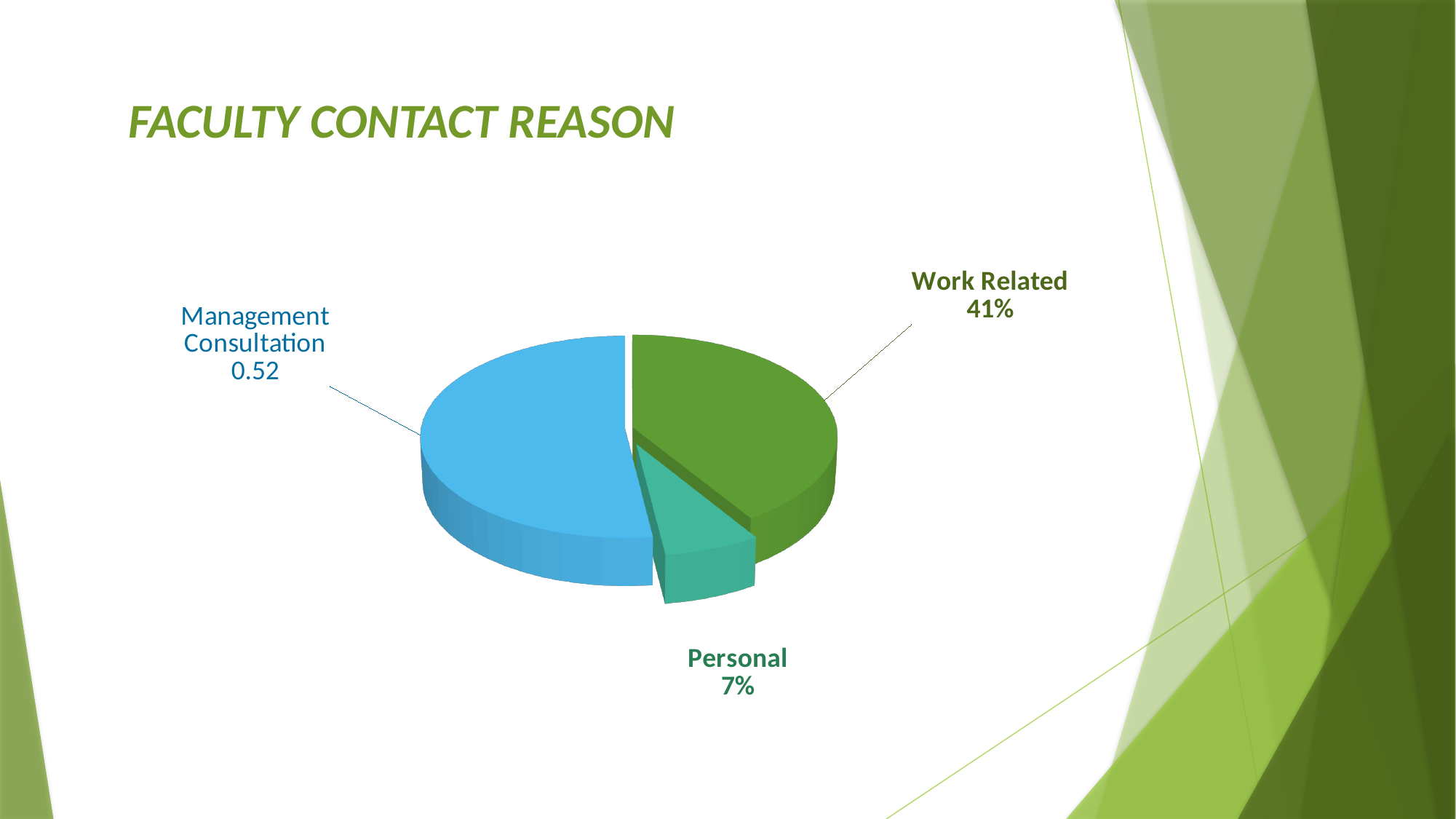
What is the title of the chart? FACULTY CONTACT REASON What is the difference between the Work Related value and the Personal value? 34% Which is larger, the Management Consultation slice or the Work Related slice? Management Consultation How many slices does the pie chart have? 3 What value is shown for Personal? 7% Which category has the smallest slice of the pie? Personal Which is larger, the Work Related slice or the Personal slice? Work Related What type of chart is shown on the slide? pie chart What colour is the Management Consultation slice? blue What value is shown for Work Related? 41% Which category has the largest slice of the pie? Management Consultation What value is shown for Management Consultation? 0.52